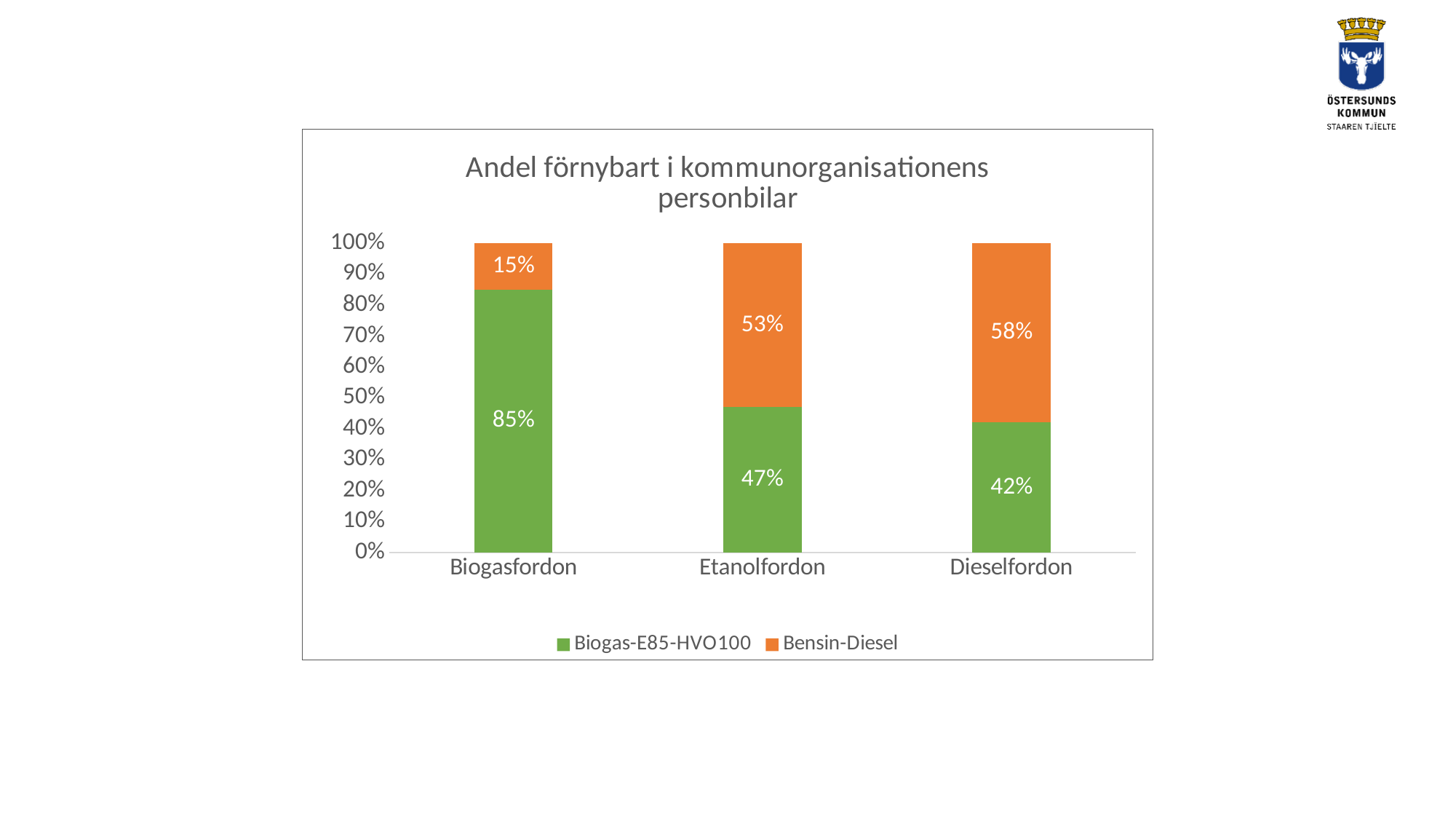
What is the Bensin-Diesel value for Biogasfordon? 15% What is the difference between the Bensin-Diesel values for Dieselfordon and Etanolfordon? 5% How many series does the legend list? 2 Which category has the lowest Bensin-Diesel value? Biogasfordon What kind of chart is shown on the slide? Stacked bar chart How many categories are shown on the x axis? 3 Which category has the highest Biogas-E85-HVO100 value? Biogasfordon What is the Biogas-E85-HVO100 value for Dieselfordon? 42% What is the Bensin-Diesel value for Etanolfordon? 53% What is the Biogas-E85-HVO100 value for Biogasfordon? 85% Which is larger: the Biogas-E85-HVO100 value for Etanolfordon or for Dieselfordon? Etanolfordon What is the title of the chart? Andel förnybart i kommunorganisationens personbilar